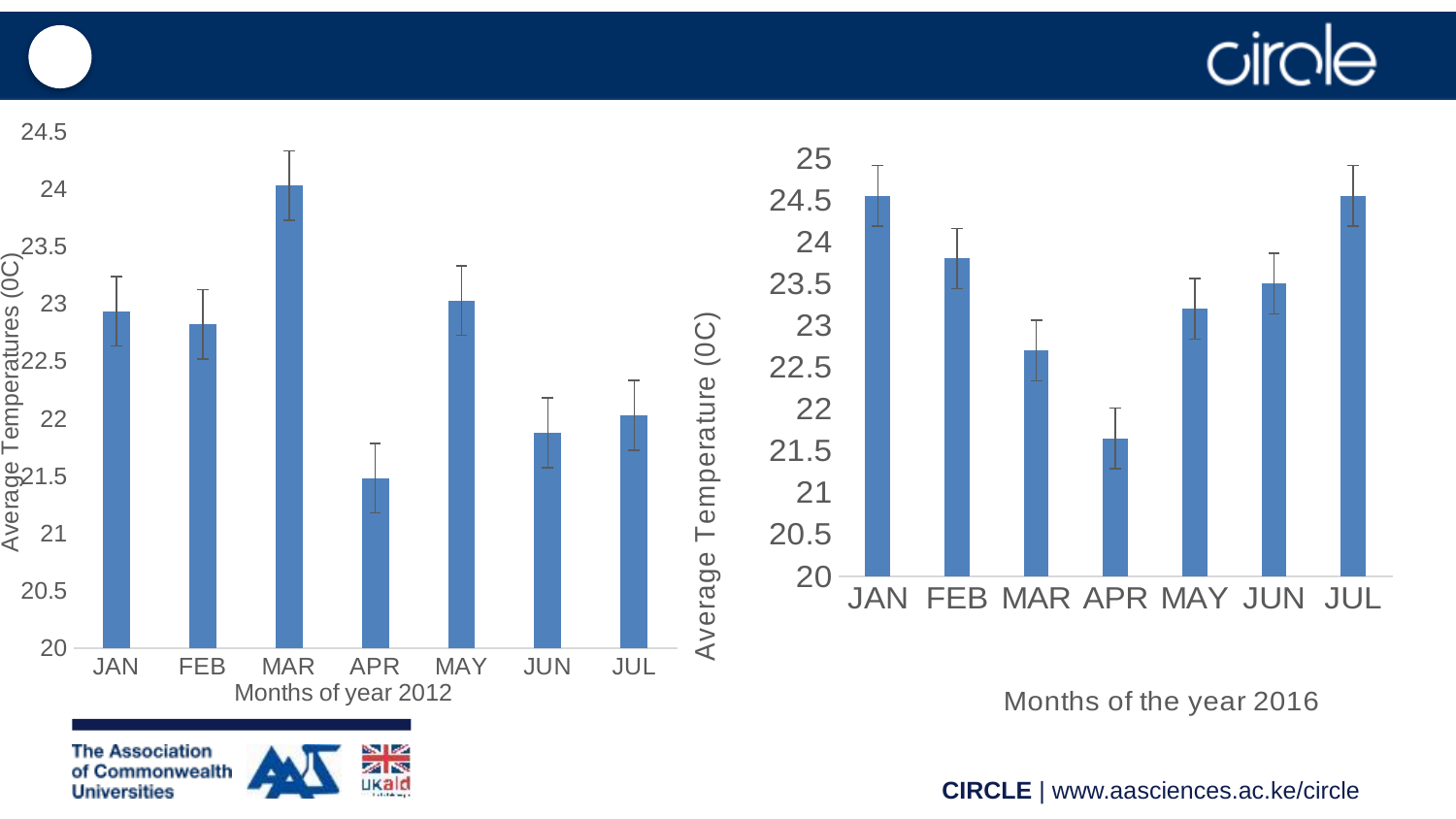
In the chart for the months of year 2012, which is larger, the value for MAR or the value for JUN? MAR How many months are shown in the chart for the months of the year 2016? 7 In the chart for the months of the year 2016, is the value for JAN greater or less than 24? greater In the chart for the months of year 2012, is the value for MAR greater or less than 23.5? greater What kind of chart is the chart for the months of year 2012? bar chart In the chart for the months of year 2012, which month has the lowest average temperature? APR In the chart for the months of the year 2016, is the value for APR greater or less than 22? less What is the x-axis title of the chart on the right of the slide? Months of the year 2016 In the chart for the months of the year 2016, which is larger, the value for FEB or the value for MAR? FEB In the chart for the months of year 2012, which month has the highest average temperature? MAR In the chart for the months of the year 2016, which month has the lowest average temperature? APR